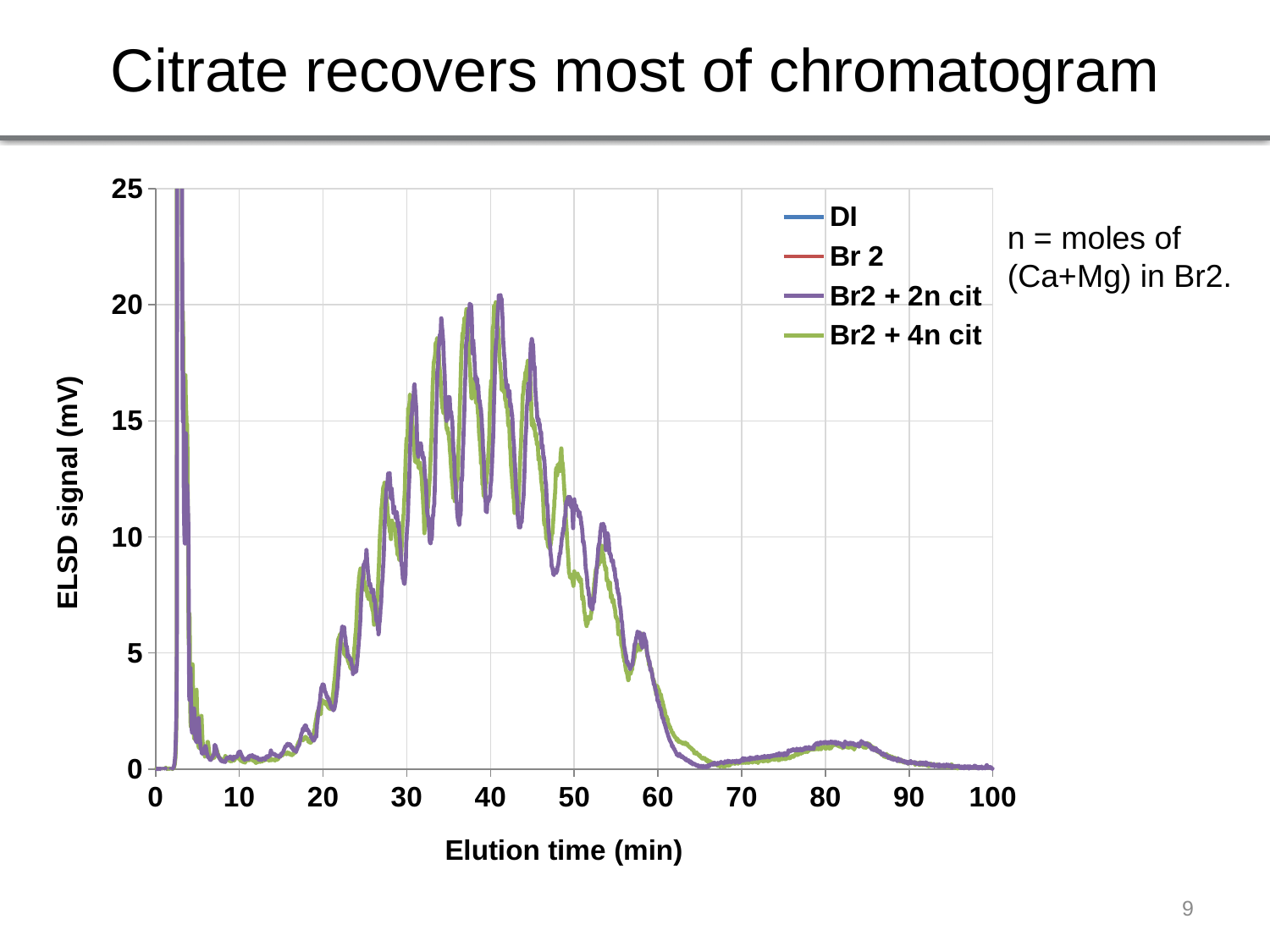
What kind of chart is shown on the slide? line chart Is the ELSD signal for Br2 + 2n cit at 70 min greater or less than 5? less Is the ELSD signal for Br2 + 4n cit at 10 min greater or less than 5? less What is the maximum value shown on the y axis? 25 Is the ELSD signal for Br2 + 2n cit at 100 min greater or less than 5? less Does the ELSD signal for Br2 + 4n cit rise or fall between 20 and 30 min? rise What is the title of the chart's x axis? Elution time (min) What is the title of the chart's y axis? ELSD signal (mV) Does the ELSD signal for Br2 + 2n cit rise or fall between 60 and 70 min? fall How many series does the legend list? 4